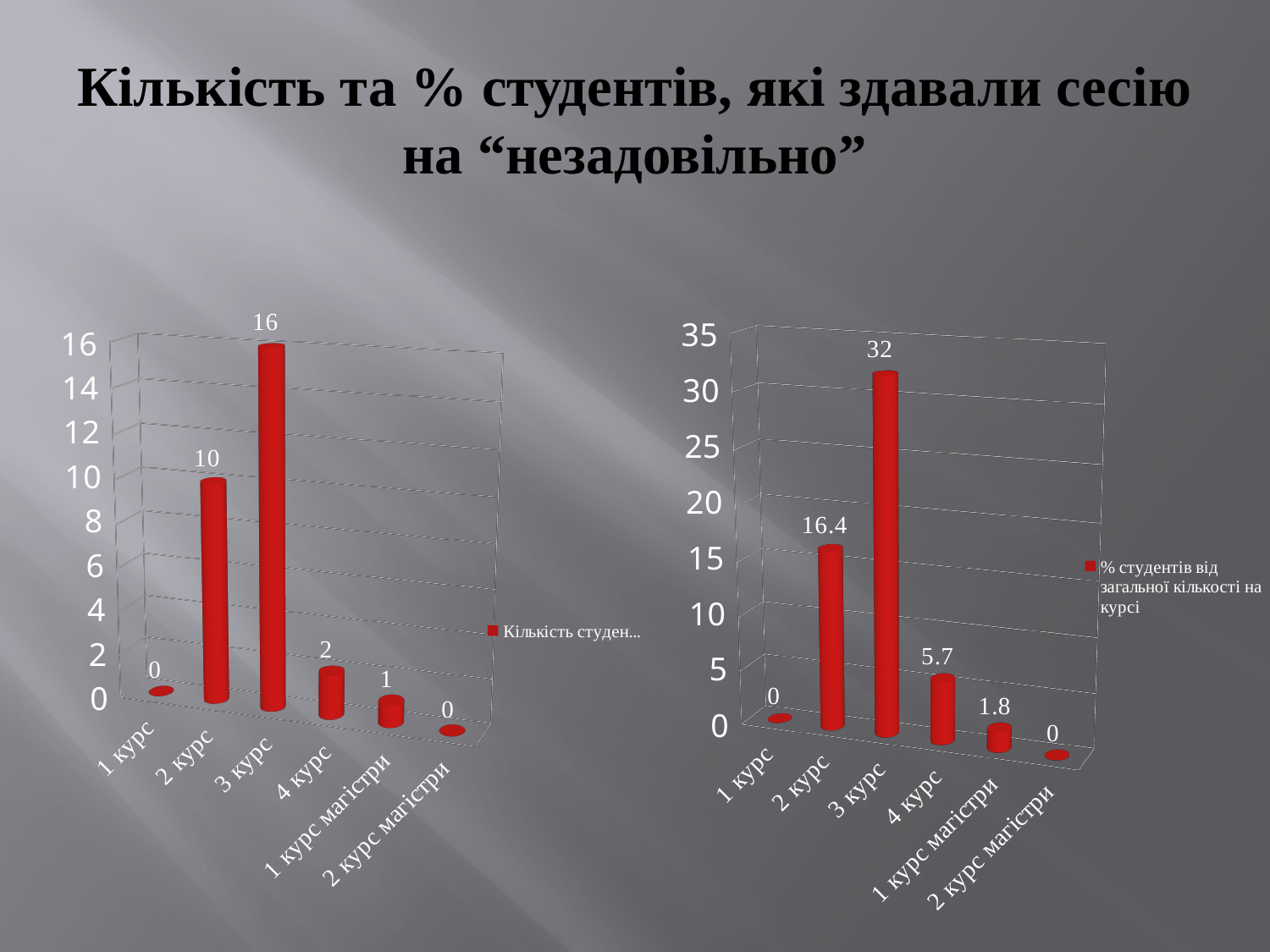
How many series does the legend of the right chart list? 1 In the left chart, what is the value for 3 курс? 16 In the left chart, which category has the highest value? 3 курс In the right chart, which category has the highest value? 3 курс In the right chart, what is the difference between the values for 4 курс and 1 курс магістри? 3.9 What kind of chart is the left chart? bar chart In the left chart, what is the difference between the values for 3 курс and 2 курс? 6 In the right chart, what is the value for 1 курс магістри? 1.8 In the right chart, what is the value for 2 курс? 16.4 How many categories are shown on the x axis of the right chart? 6 In the left chart, which is larger: the value for 4 курс or the value for 1 курс магістри? 4 курс In the left chart, what is the value for 2 курс? 10